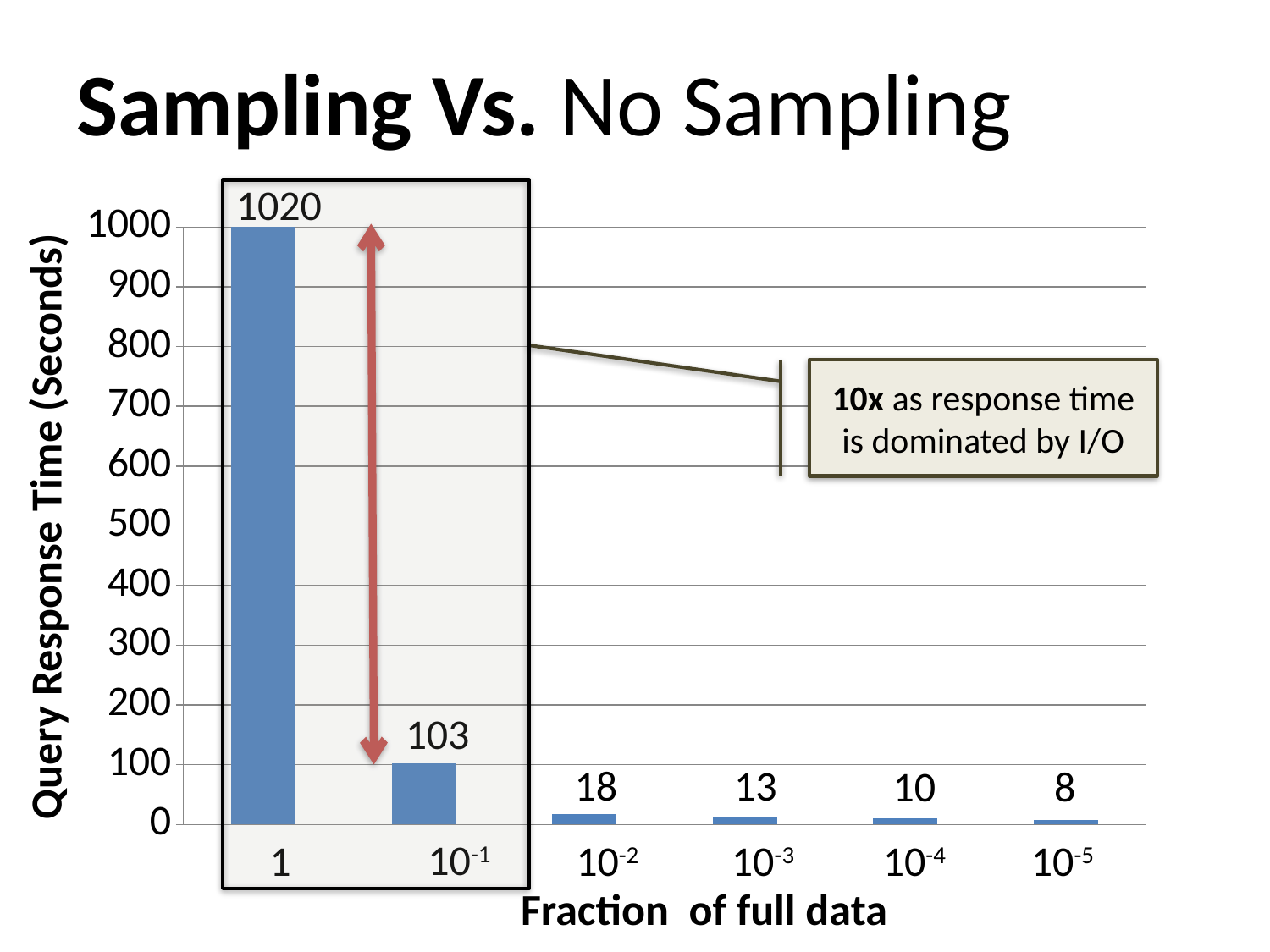
What is the query response time when the fraction of full data is 1? 1020 What is the query response time when the fraction of full data is 10^-1? 103 What is the query response time when the fraction of full data is 10^-3? 13 Do the query response times rise or fall as the fraction of full data decreases along the x axis? Fall Which fraction of full data has the lowest query response time? 10^-5 What is the query response time when the fraction of full data is 10^-5? 8 What is the difference in query response time between fraction 1 and fraction 10^-1? 917 How many fractions of full data are plotted on the chart? 6 Which fraction of full data has the highest query response time? 1 What kind of chart is shown on the slide? Bar chart What is the difference in query response time between fraction 10^-2 and fraction 10^-4? 8 Which has a larger query response time: fraction 10^-2 or fraction 10^-3? 10^-2